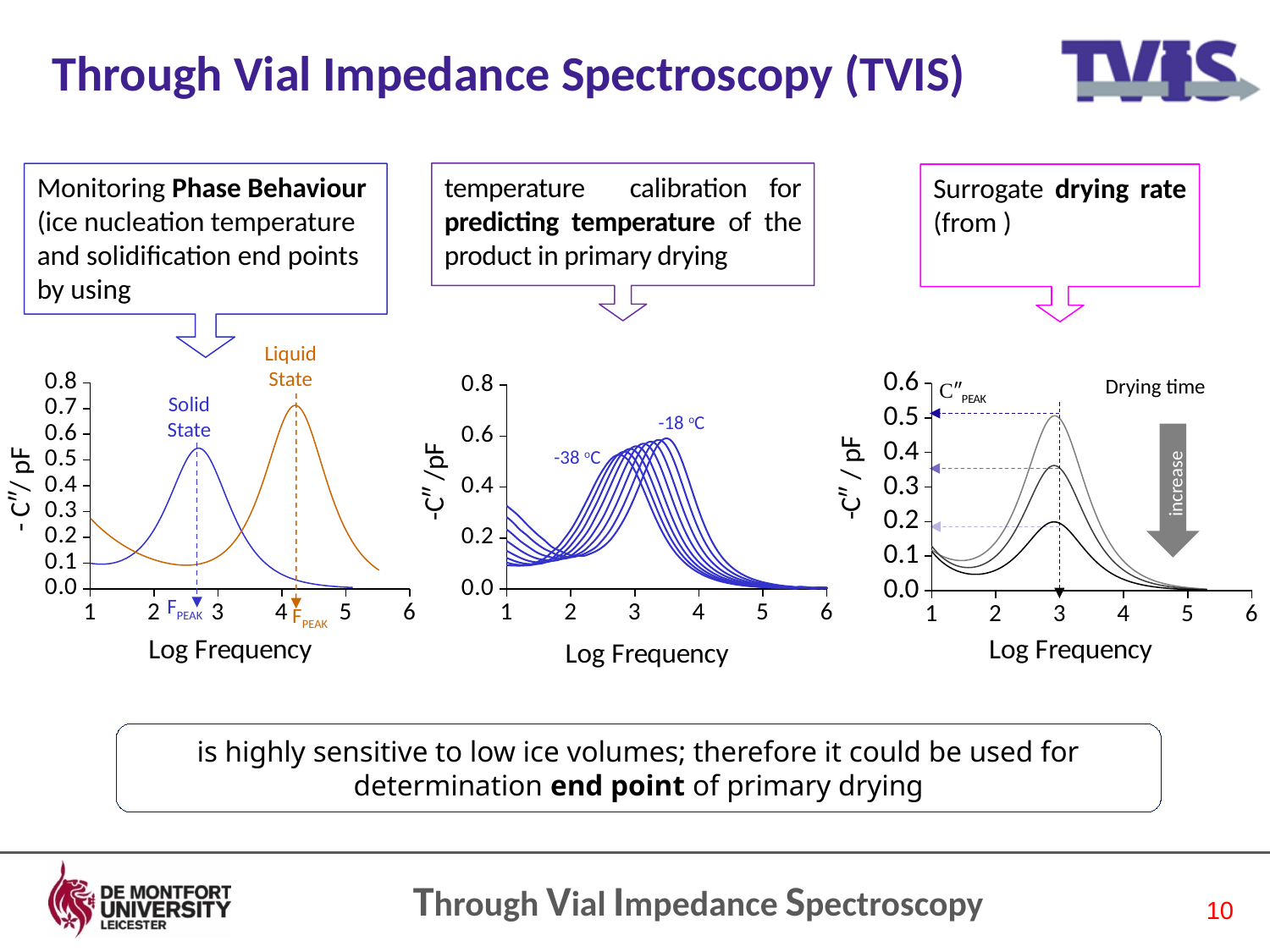
On the middle chart, is the peak value of the -18 °C curve greater or less than 0.4? greater On the right chart, is the peak value of the lowest curve greater or less than 0.3? less On the left chart, is the peak value of the Liquid State curve greater or less than 0.6? greater On the left chart, which curve reaches the higher peak, Solid State or Liquid State? Liquid State On the middle chart, how many tick values are shown on the Log Frequency axis? 6 On the middle chart, what temperature labels the curve with the highest-frequency peak? -18 °C On the left chart, what is the label of the x axis? Log Frequency What kind of chart is the left chart showing Solid State and Liquid State? line chart On the left chart, what is the highest value shown on the y axis? 0.8 On the right chart, how many curves are plotted? 3